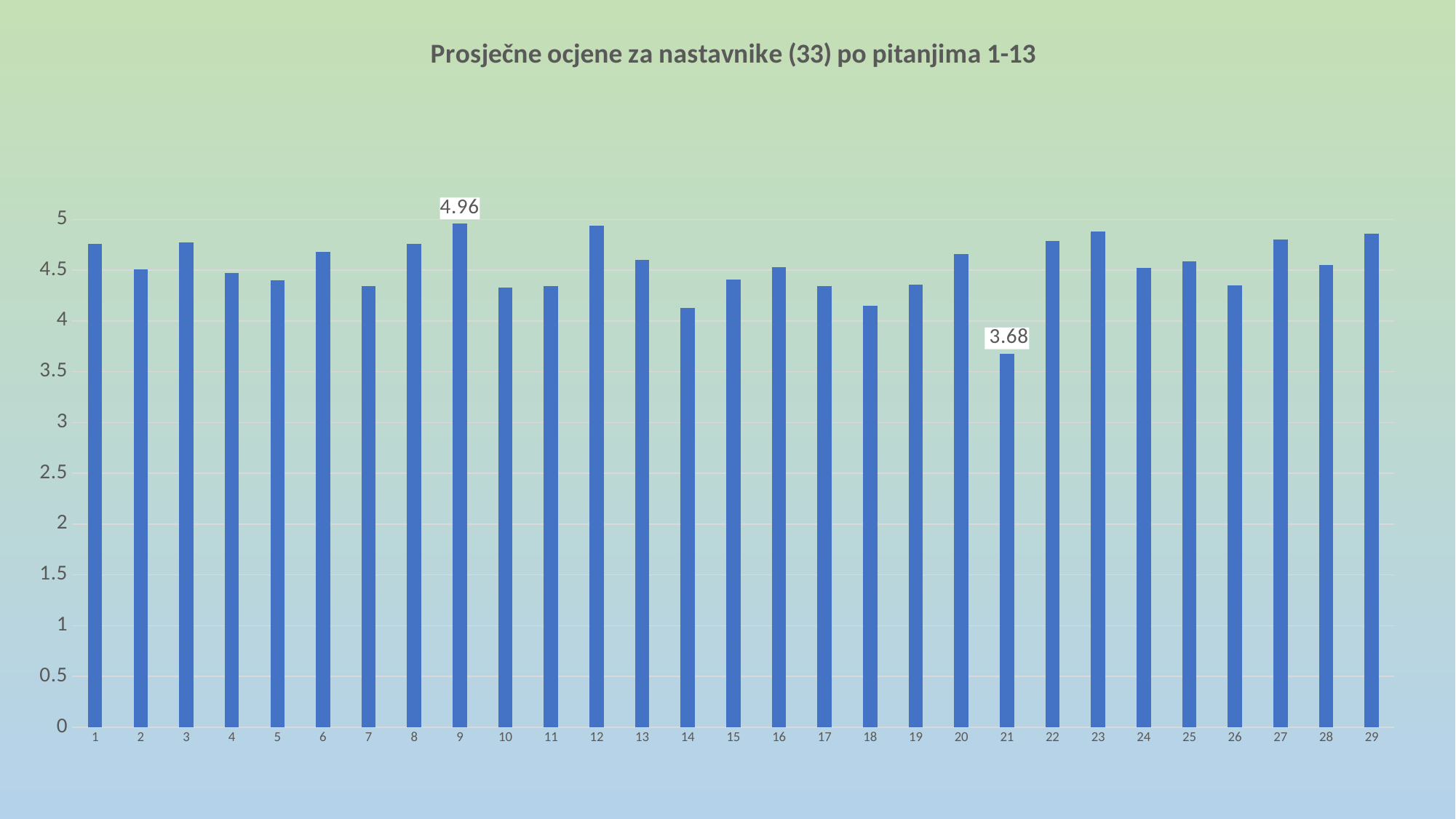
Which category has the lowest value? 21 What is the value for category 21? 3.68 Is the value for category 12 greater or less than 4.5? greater What kind of chart is this? bar chart What is the difference between the values for category 9 and category 21? 1.28 Which is larger, the value for category 14 or the value for category 21? category 14 Is the value for category 14 greater or less than 4.5? less What is the title of the chart? Prosječne ocjene za nastavnike (33) po pitanjima 1-13 Which category has the highest value? 9 Is the value for category 23 greater or less than 4.5? greater How many categories are shown on the x axis? 29 What is the value for category 9? 4.96